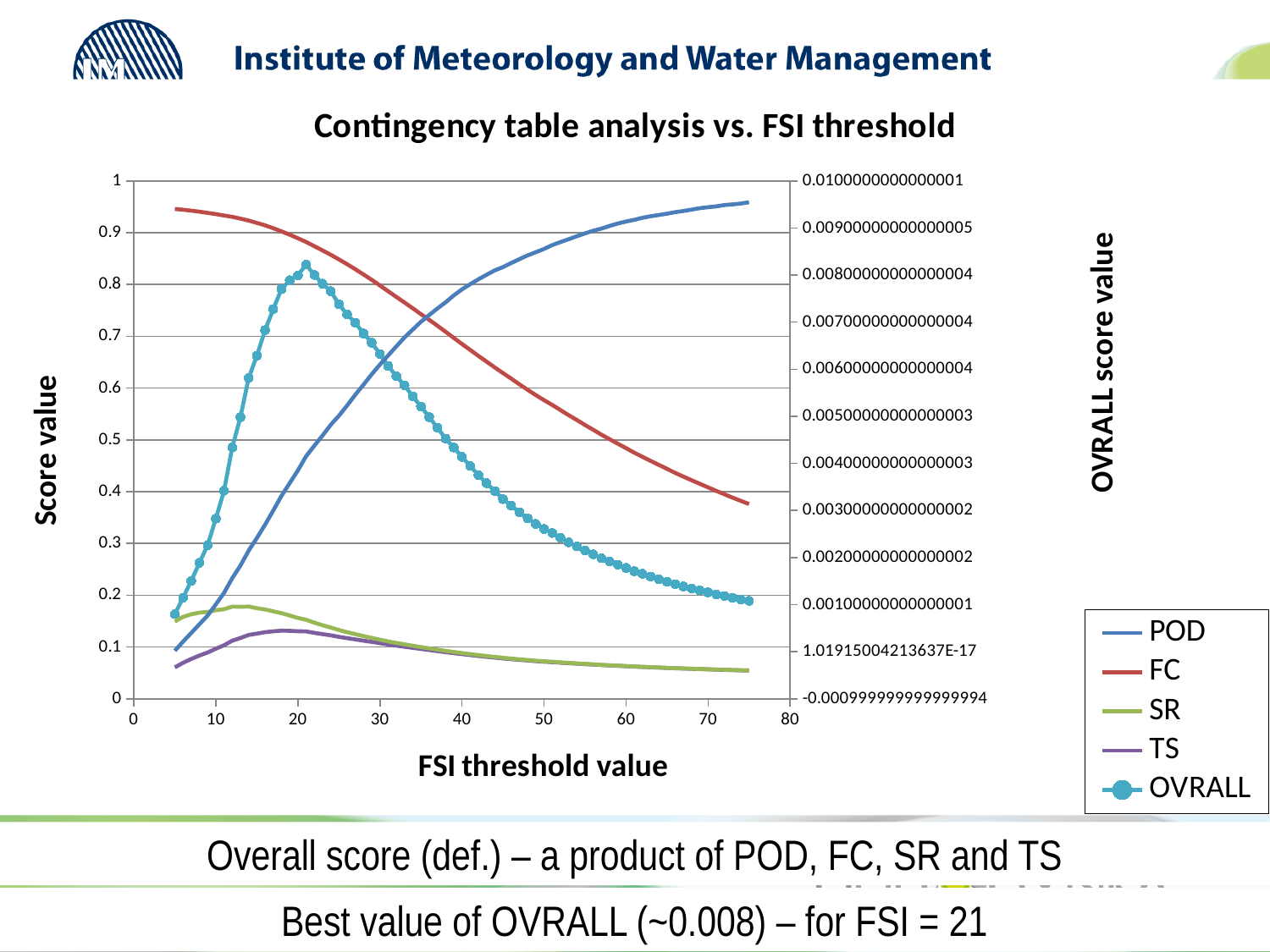
Is the FC value at FSI threshold 50 greater or less than 0.5? greater What is the title of the chart? Contingency table analysis vs. FSI threshold Which series has the lowest value at FSI threshold 5? TS At FSI threshold 20, which is larger, POD or FC? FC What kind of chart is shown on the slide? line chart How many series does the legend list? 5 Is the SR value at FSI threshold 70 greater or less than 0.1? less What is the label of the x axis? FSI threshold value Is the POD value at FSI threshold 70 greater or less than 0.9? greater Does the FC series rise or fall as the FSI threshold value increases? fall Does the POD series rise or fall as the FSI threshold value increases? rise